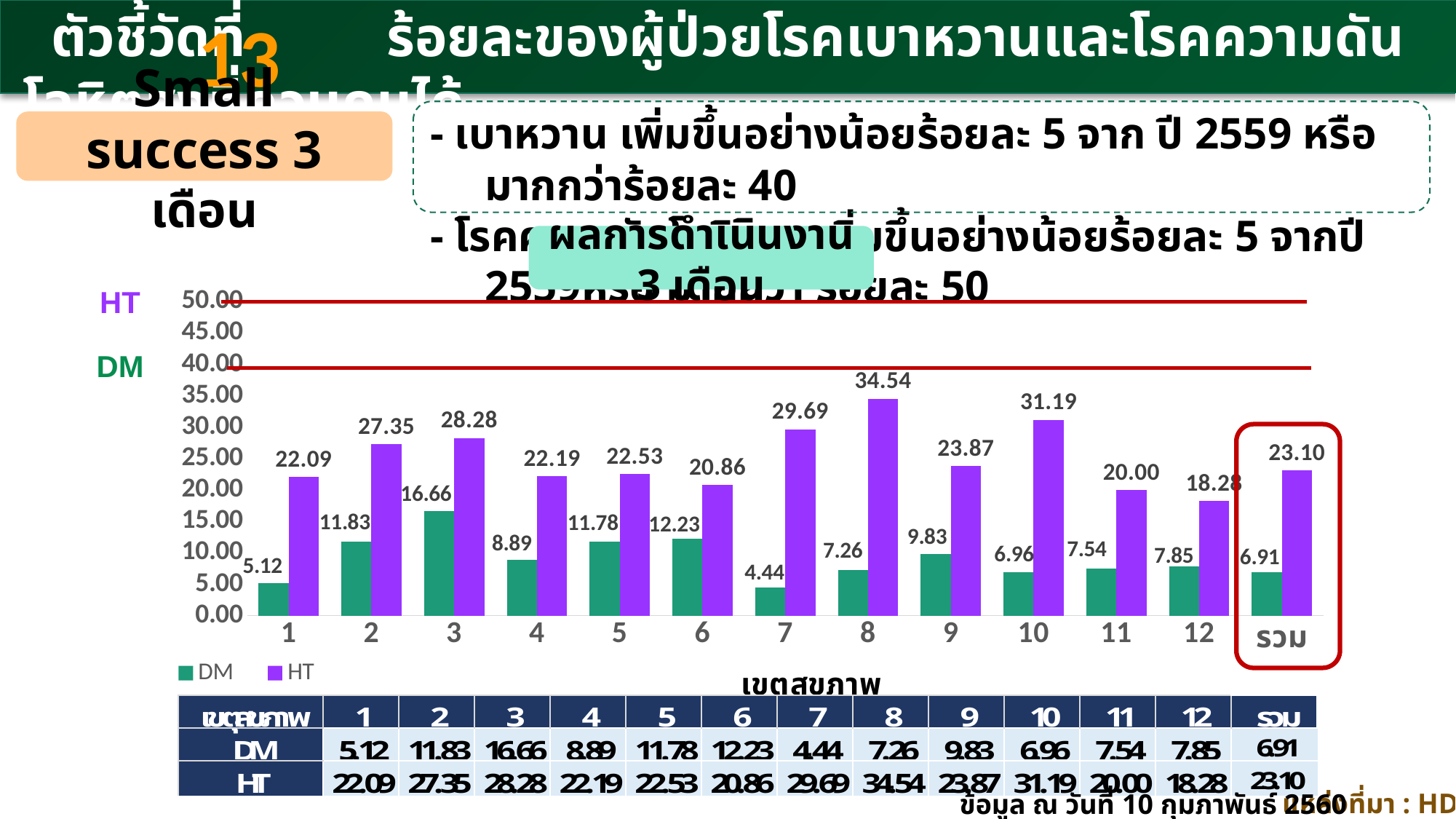
What is the HT value for category 8? 34.54 What kind of chart is shown on the slide? bar chart How many categories are shown on the x axis of the chart? 13 Which is larger, the DM value for category 2 or the DM value for category 5? category 2 What is the DM value for category 7? 4.44 Which category has the lowest HT value? 12 Which category has the lowest DM value? 7 What is the DM value for category 3? 16.66 How many series does the chart legend list? 2 Which category has the highest HT value? 8 What is the difference between the HT and DM values for category 8? 27.28 What is the HT value for the รวม category? 23.10